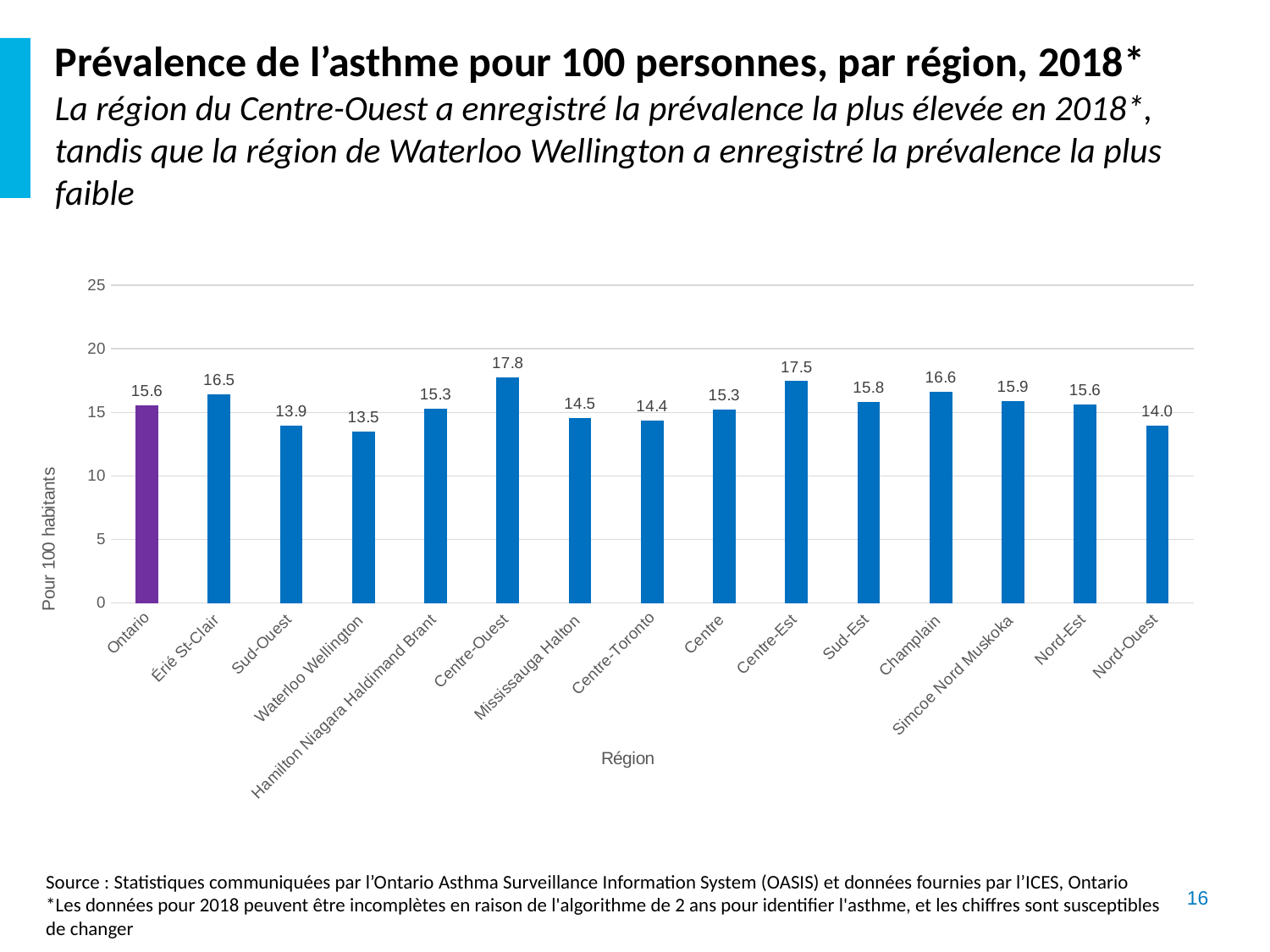
Which region has the highest asthma prevalence? Centre-Ouest Which has a higher value, Centre-Est or Mississauga Halton? Centre-Est Which region has the lowest asthma prevalence? Waterloo Wellington What is the difference between the values for Centre-Ouest and Waterloo Wellington? 4.3 What is the asthma prevalence per 100 people for Centre-Ouest? 17.8 What is the value shown for Champlain? 16.6 What type of chart is shown on the slide? Bar chart What is the difference between the values for Érié St-Clair and Sud-Ouest? 2.6 How many regions (bars) are shown in the chart? 15 What is the value shown for Ontario? 15.6 Is the value for Nord-Ouest greater or less than 15? less What is the value shown for Waterloo Wellington? 13.5